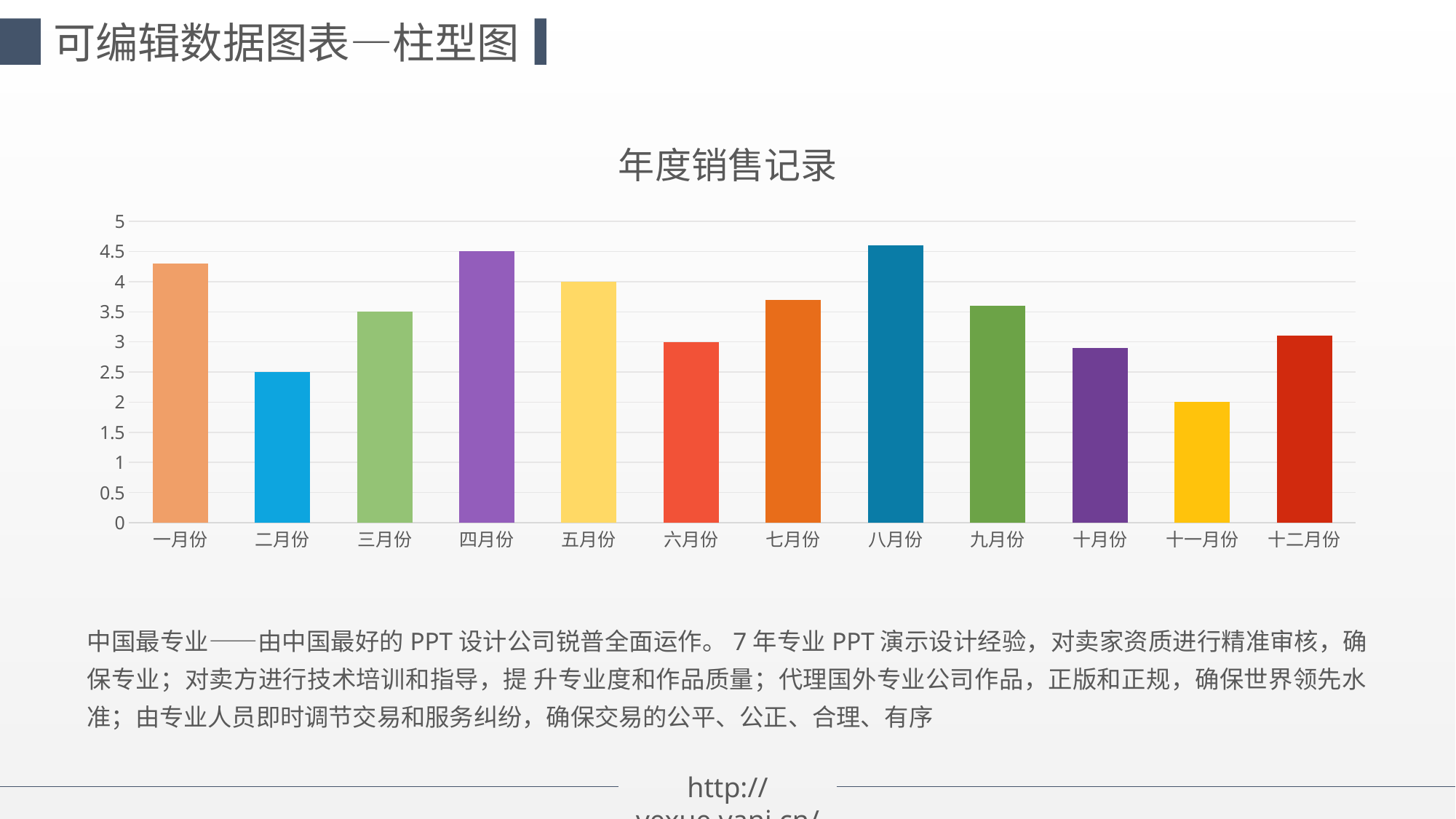
Which month has the lowest value? 十一月份 What is the value for 二月份? 2.5 Is the value for 一月份 greater or less than 4? greater What is the value for 十一月份? 2 What is the value for 六月份? 3 What is the title of the chart? 年度销售记录 Which is larger, the value for 四月份 or the value for 五月份? 四月份 Do the values rise or fall from 八月份 to 十一月份? fall What is the difference between the values for 四月份 and 二月份? 2 What is the value for 四月份? 4.5 What kind of chart is shown on the slide? bar chart How many months (categories) are plotted on the x axis? 12